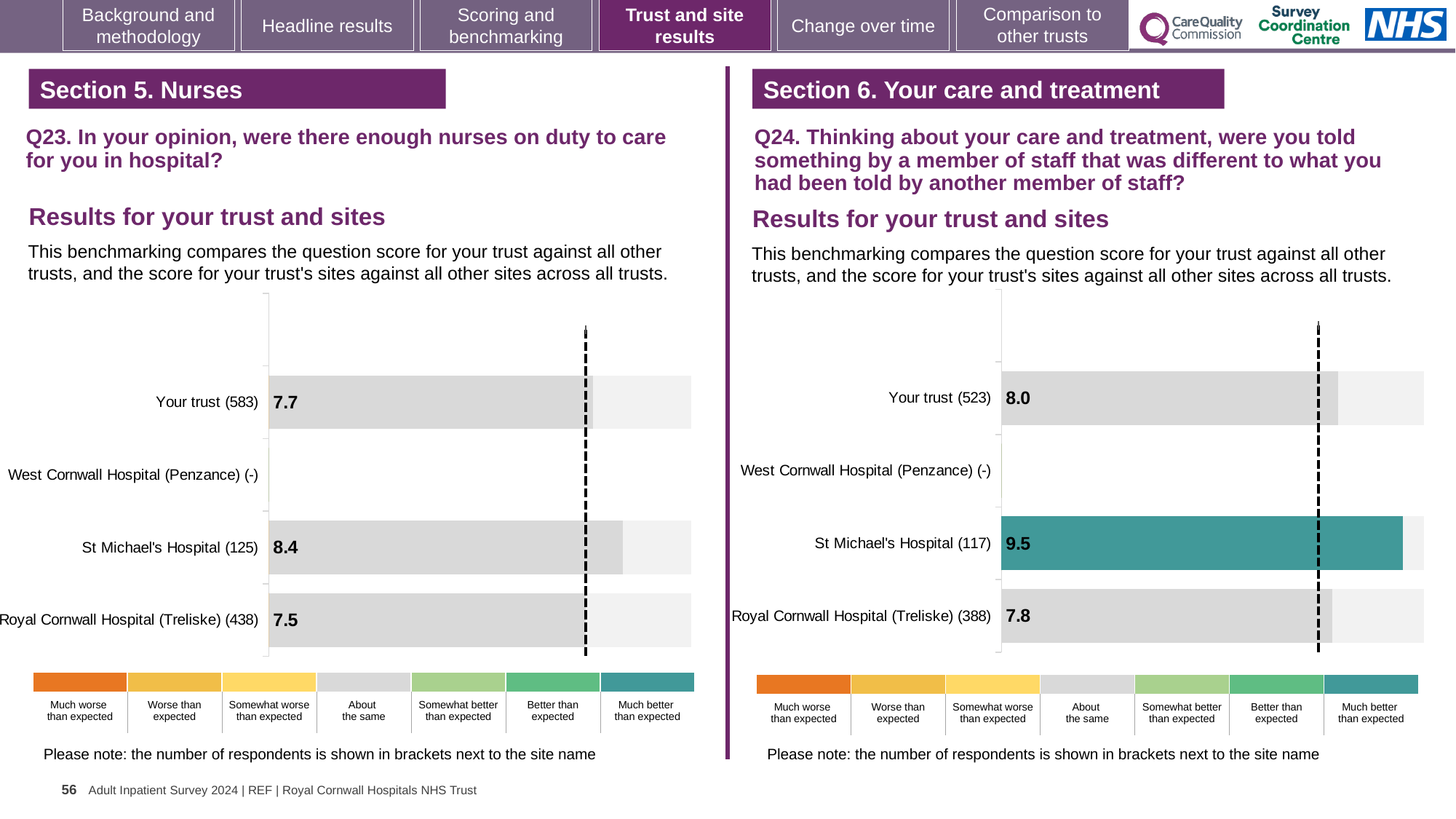
On the Q23 chart (left), which site has the highest score? St Michael's Hospital What kind of chart is used on the Q23 chart (left)? Bar chart On the Q24 chart (right), what is the score for Royal Cornwall Hospital (Treliske)? 7.8 On the Q23 chart (left), what is the difference between the scores for St Michael's Hospital and Royal Cornwall Hospital (Treliske)? 0.9 On the Q24 chart (right), what is the difference between the scores for St Michael's Hospital and Your trust? 1.5 On the Q23 chart (left), what is the score for St Michael's Hospital? 8.4 On the Q24 chart (right), how many respondents are shown in brackets for Your trust? 523 On the Q23 chart (left), what is the score for Royal Cornwall Hospital (Treliske)? 7.5 On the Q24 chart (right), what is the score for Your trust? 8.0 On the Q23 chart (left), what is the score for Your trust? 7.7 On the Q24 chart (right), what is the score for St Michael's Hospital? 9.5 On the Q24 chart (right), which site has the lowest score among those with a value shown? Royal Cornwall Hospital (Treliske)